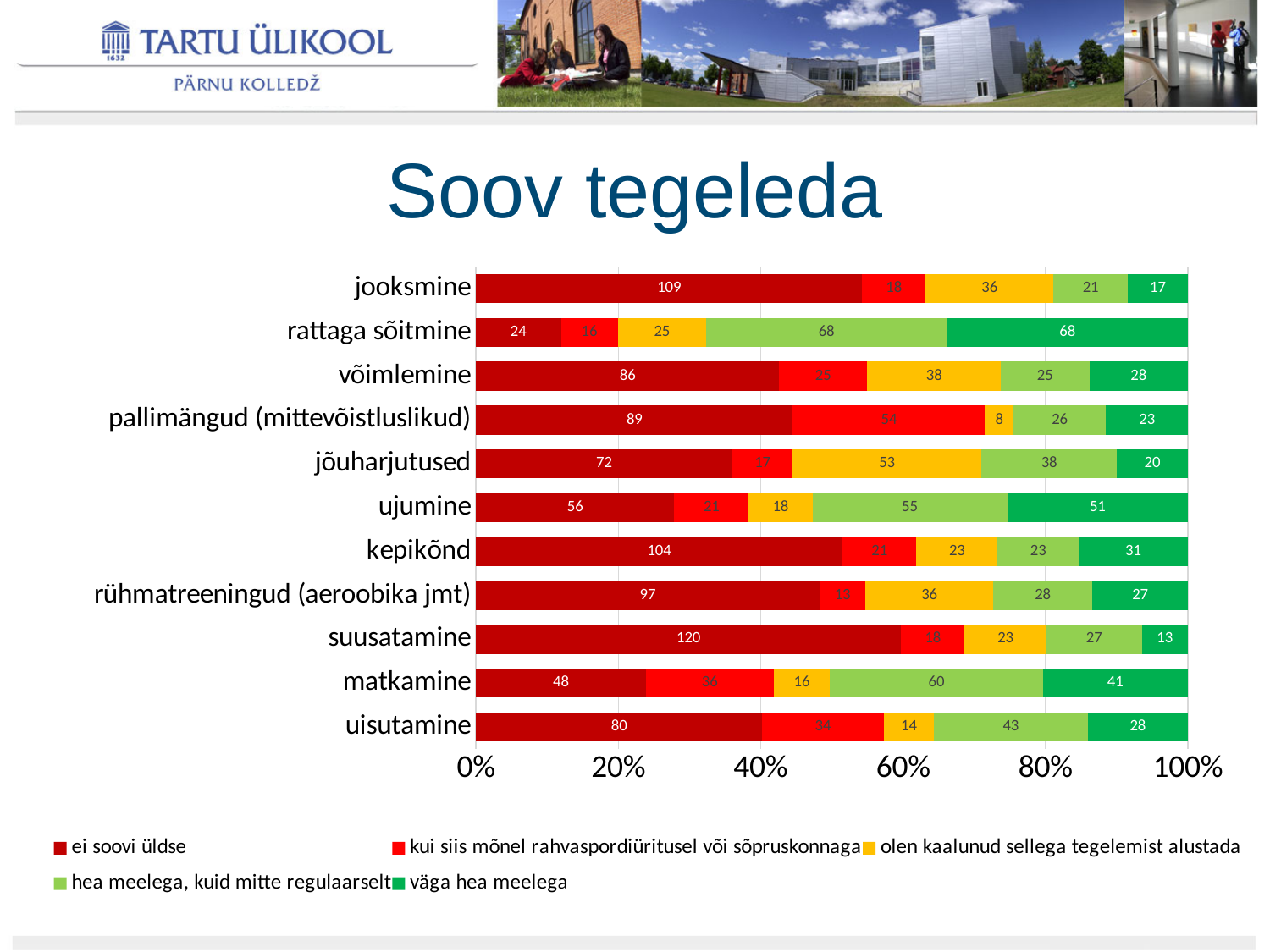
How many activities (categories) are listed on the chart? 11 What is the total of all segments in the ujumine bar? 201 Which activity has the lowest 'ei soovi üldse' value? rattaga sõitmine What is the difference between the 'ei soovi üldse' values for jooksmine and kepikõnd? 5 What kind of chart is shown on the slide? stacked bar chart What is the 'olen kaalunud sellega tegelemist alustada' value for jõuharjutused? 53 What is the 'väga hea meelega' value for rattaga sõitmine? 68 How many series does the legend list? 5 Which activity has the highest 'ei soovi üldse' value? suusatamine What is the 'ei soovi üldse' value for suusatamine? 120 What is the title of the chart? Soov tegeleda Which is larger: the 'hea meelega, kuid mitte regulaarselt' value for matkamine or for uisutamine? matkamine